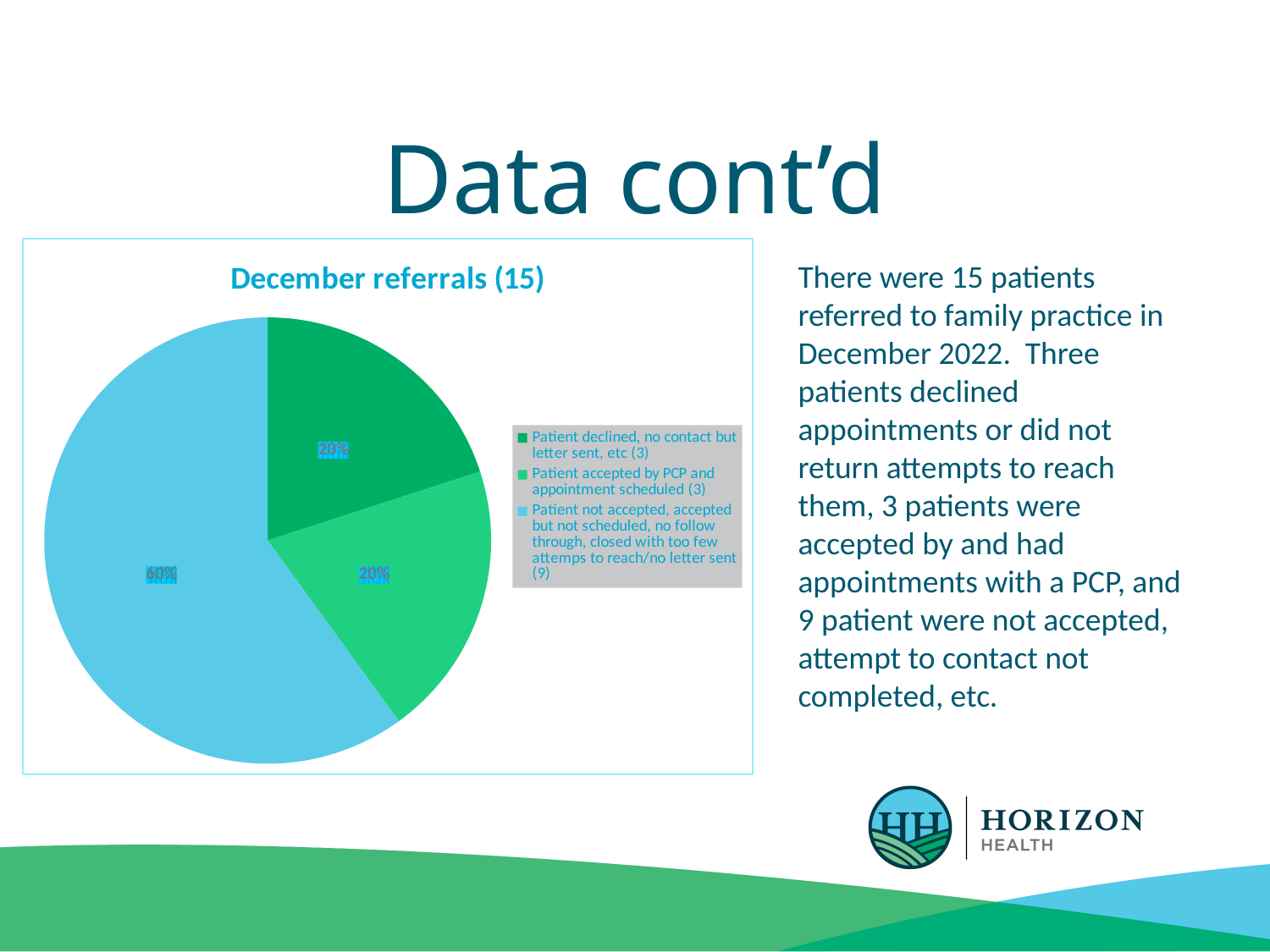
Which is larger: the slice for 'Patient not accepted, accepted but not scheduled...' or the slice for 'Patient declined, no contact but letter sent, etc'? Patient not accepted, accepted but not scheduled... What is the title of the chart? December referrals (15) According to the legend, how many patients were in the 'Patient declined, no contact but letter sent, etc' category? 3 How many slices does the pie chart have? 3 What share of the pie is the slice for 'Patient accepted by PCP and appointment scheduled'? 20% According to the legend, how many patients were in the 'Patient not accepted, accepted but not scheduled...' category? 9 What share of the pie is the slice for 'Patient declined, no contact but letter sent, etc'? 20% How many entries does the chart's legend list? 3 Which category has the largest slice of the pie? Patient not accepted, accepted but not scheduled, no follow through, closed with too few attemps to reach/no letter sent What kind of chart is shown on the slide? pie chart What is the difference in percentage points between the largest slice and the slice for 'Patient accepted by PCP and appointment scheduled'? 40 percentage points What share of the pie is the slice for 'Patient not accepted, accepted but not scheduled, no follow through, closed with too few attemps to reach/no letter sent'? 60%